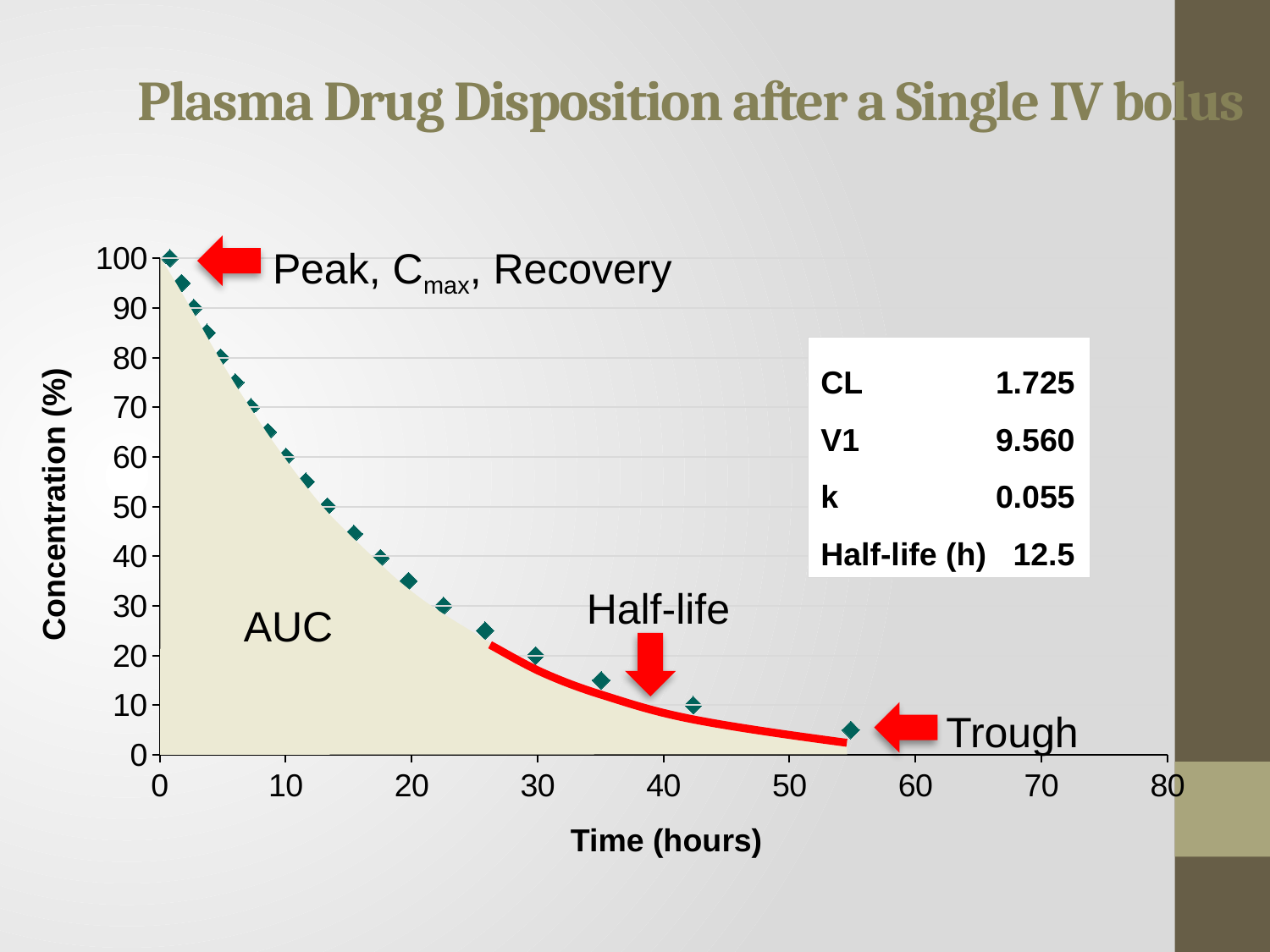
What is the label of the x axis? Time (hours) What is the concentration at time 0 hours? 100 Do the plotted concentration values rise or fall as time increases? fall At what time is the plotted concentration highest? 0 hours Which is larger, the concentration at 20 hours or at 40 hours? 20 hours Is the concentration at 55 hours greater or less than 10? less What is the title of the chart? Plasma Drug Disposition after a Single IV bolus Is the concentration at 20 hours greater or less than 40? less What is the half-life value shown in the table on the chart? 12.5 Is the concentration at 15 hours greater or less than 50? less